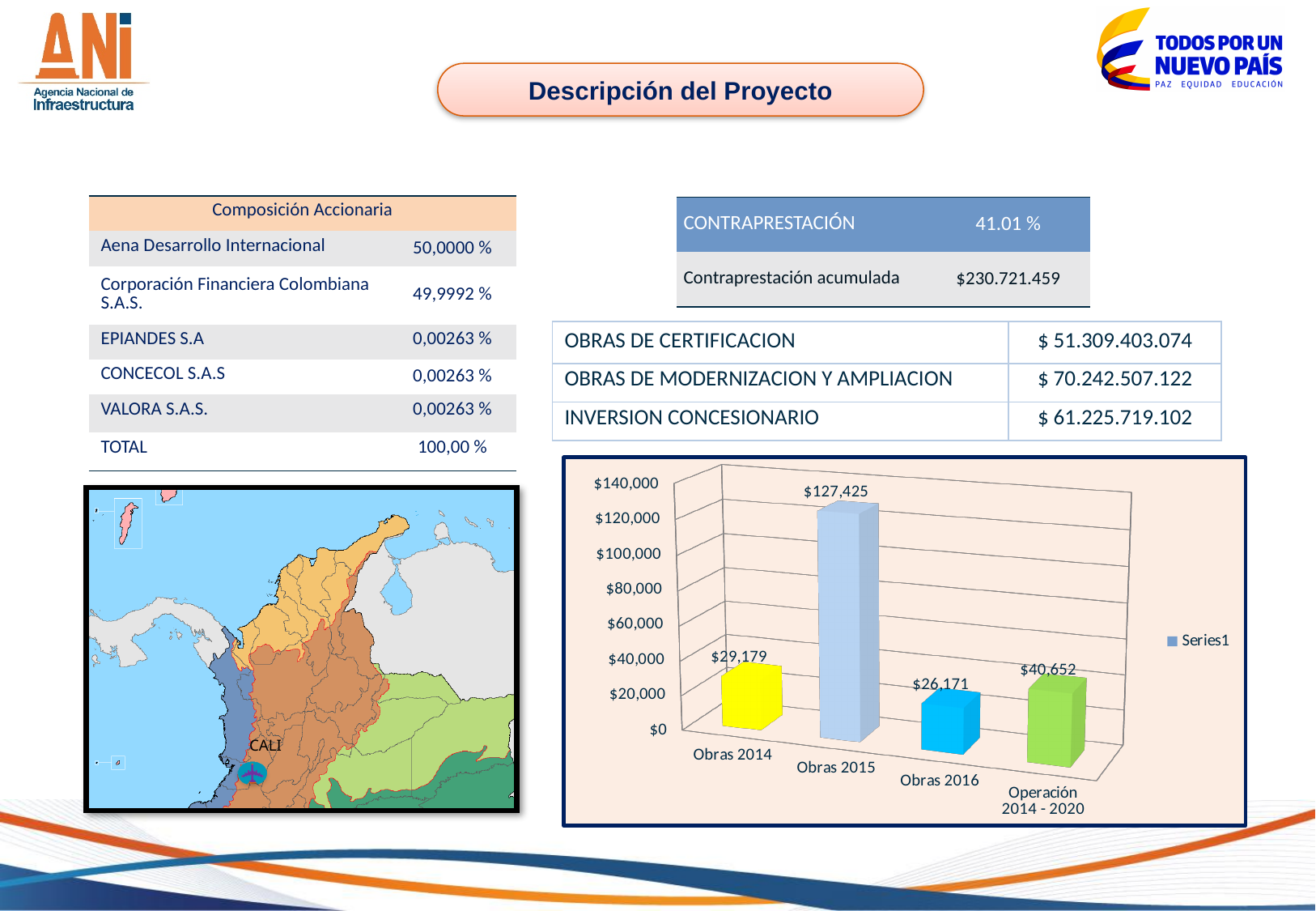
What is the value for Obras 2014 in the bar chart? $29,179 Is the value for Obras 2015 in the bar chart greater or less than $100,000? greater What is the value for Operación 2014 - 2020 in the bar chart? $40,652 How many series does the legend of the bar chart list? 1 What is the value for Obras 2015 in the bar chart? $127,425 What is the difference between the values for Obras 2015 and Obras 2014 in the bar chart? $98,246 How many categories are shown in the bar chart? 4 Which category has the highest value in the bar chart? Obras 2015 What kind of chart is shown on the slide? bar chart Which is larger in the bar chart, the value for Operación 2014 - 2020 or the value for Obras 2014? Operación 2014 - 2020 What is the value for Obras 2016 in the bar chart? $26,171 Which category has the lowest value in the bar chart? Obras 2016